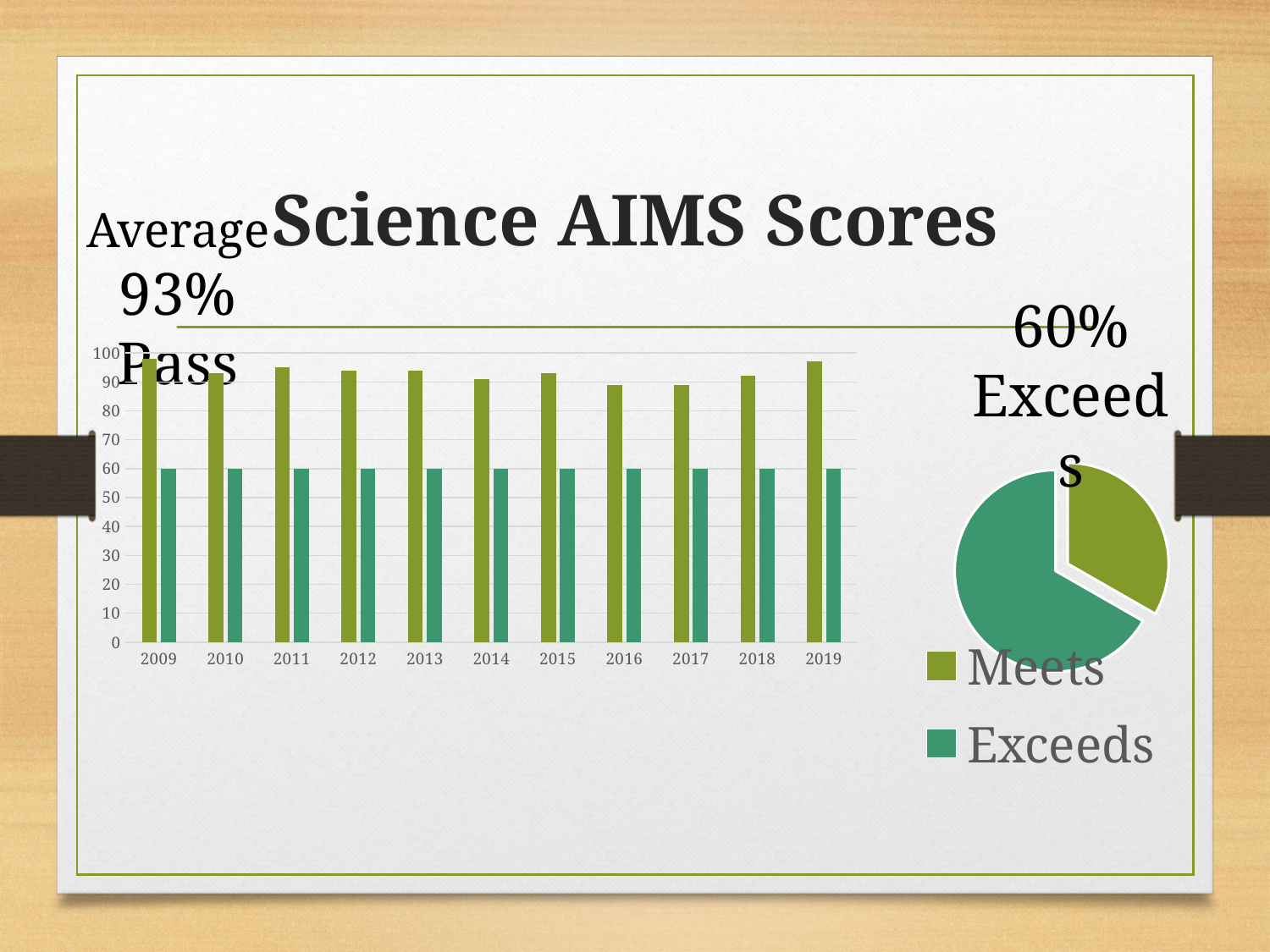
What are the two entries in the legend? Meets and Exceeds What kind of chart is the chart on the left of the slide? bar chart What kind of chart is the chart on the right of the slide? pie chart In the pie chart, which slice is larger, Meets or Exceeds? Exceeds In the bar chart, how many years are shown on the x axis? 11 How many series does the legend list? 2